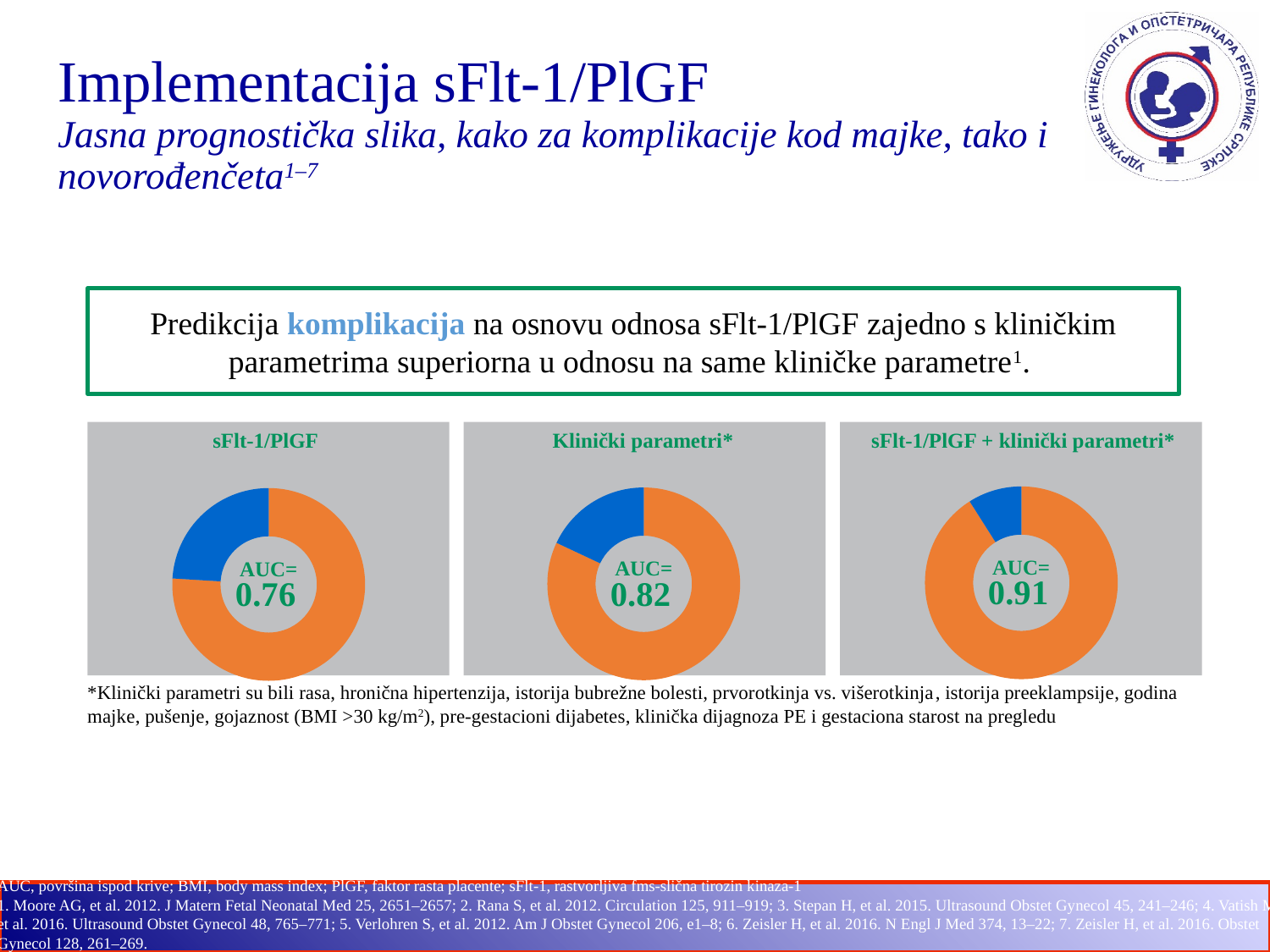
Which of the three donut charts shows the highest AUC value? sFlt-1/PlGF + klinički parametri* How many donut charts are shown on the slide? 3 What two colours are used for the slices in each donut chart? Orange and blue What AUC value is shown in the centre of the Klinički parametri* donut chart? 0.82 Which has the larger AUC: the sFlt-1/PlGF chart or the Klinički parametri* chart? Klinički parametri* What is the difference between the AUC of the sFlt-1/PlGF + klinički parametri* chart and the AUC of the sFlt-1/PlGF chart? 0.15 What AUC value is shown in the centre of the sFlt-1/PlGF donut chart? 0.76 Which of the three donut charts shows the lowest AUC value? sFlt-1/PlGF What kind of chart is used to display the AUC values on the slide? Donut (pie) chart What is the difference between the AUC of the sFlt-1/PlGF + klinički parametri* chart and the AUC of the Klinički parametri* chart? 0.09 What is the difference between the AUC of the Klinički parametri* chart and the AUC of the sFlt-1/PlGF chart? 0.06 What AUC value is shown in the centre of the sFlt-1/PlGF + klinički parametri* donut chart? 0.91